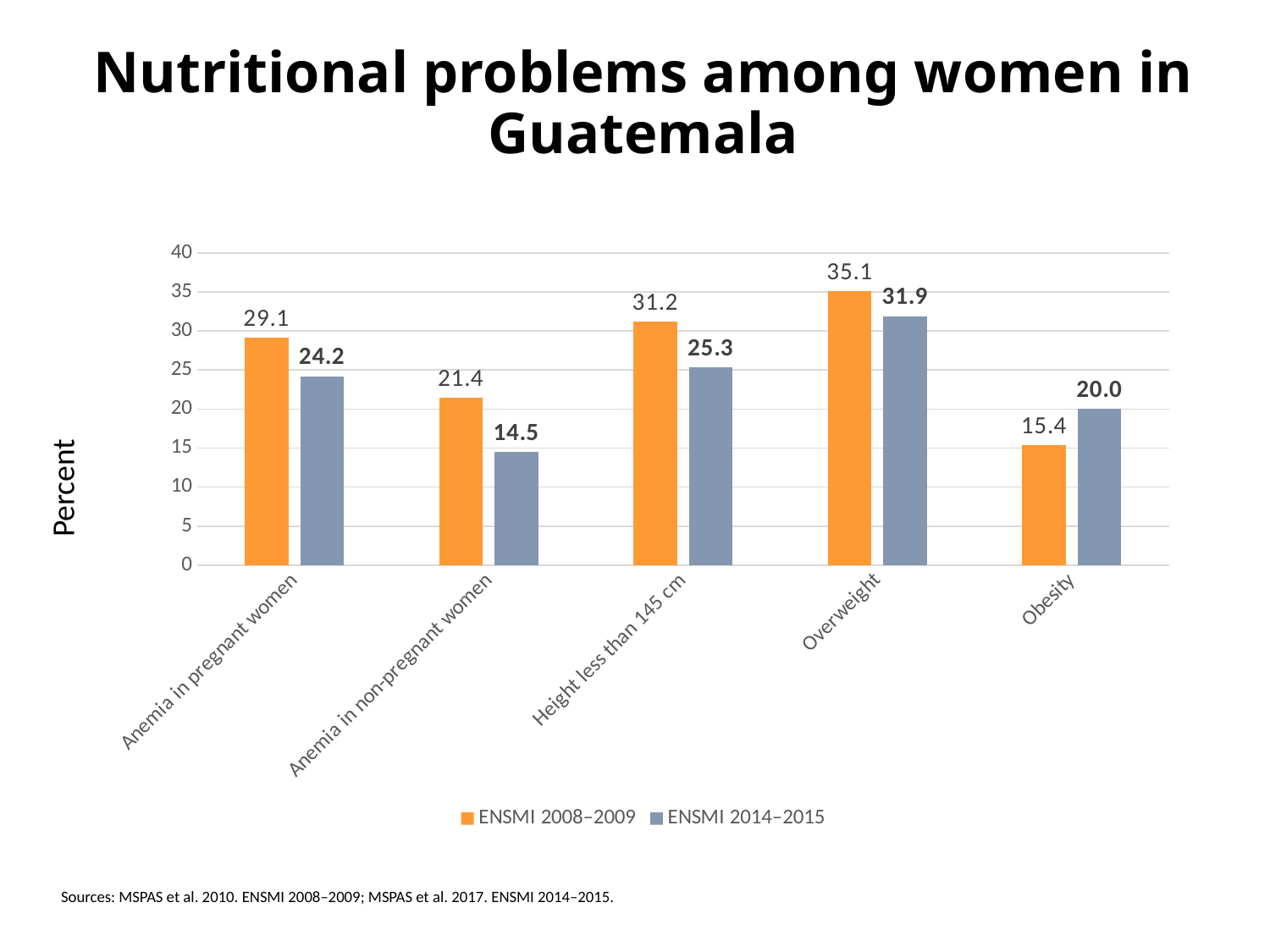
What kind of chart is shown on the slide? Bar chart Which category has the lowest value in the ENSMI 2014–2015 series? Anemia in non-pregnant women What is the difference between the ENSMI 2008–2009 and ENSMI 2014–2015 values for Anemia in non-pregnant women? 6.9 How many series does the legend list? 2 For Obesity, which series has the larger value, ENSMI 2008–2009 or ENSMI 2014–2015? ENSMI 2014–2015 What is the label of the y axis? Percent Which category has the highest value in the ENSMI 2008–2009 series? Overweight What is the value for Obesity in the ENSMI 2014–2015 series? 20.0 What is the value for Anemia in non-pregnant women in the ENSMI 2014–2015 series? 14.5 Is the ENSMI 2014–2015 value for Height less than 145 cm greater or less than 30? less What is the value for Overweight in the ENSMI 2008–2009 series? 35.1 How many categories are shown on the x axis? 5